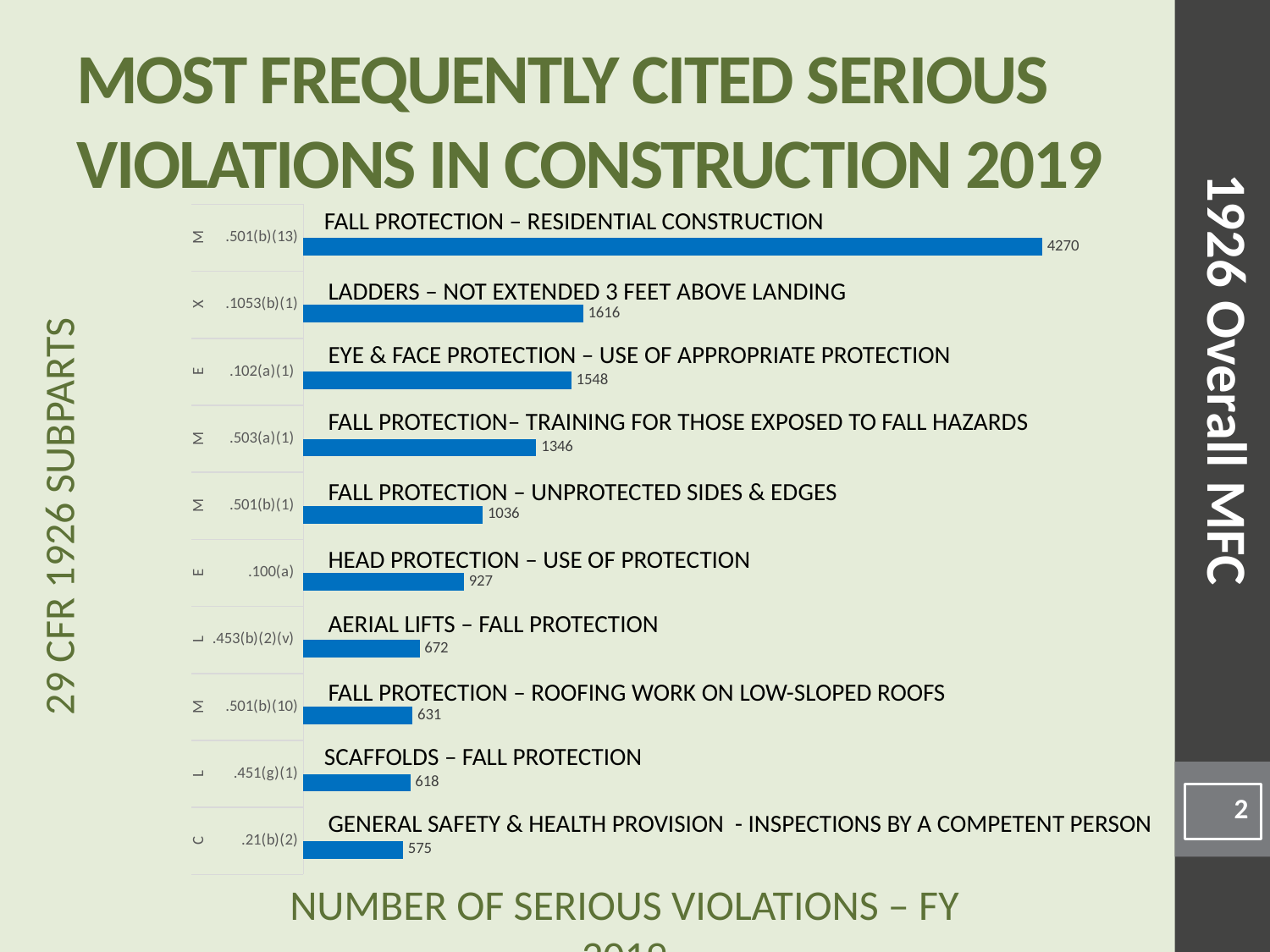
How many serious violations are shown for Fall Protection – Residential Construction (.501(b)(13))? 4270 What kind of chart is shown on the slide? Bar chart Which has a larger value: Fall Protection – Training for Those Exposed to Fall Hazards or Fall Protection – Unprotected Sides & Edges? Fall Protection – Training for Those Exposed to Fall Hazards Which has a larger value: Aerial Lifts – Fall Protection or Fall Protection – Roofing Work on Low-Sloped Roofs? Aerial Lifts – Fall Protection How many categories are shown in the chart? 10 What is the value for Head Protection – Use of Protection (.100(a))? 927 Which category has the lowest number of serious violations? General Safety & Health Provision - Inspections by a Competent Person What is the value for Scaffolds – Fall Protection (.451(g)(1))? 618 Which category has the highest number of serious violations? Fall Protection – Residential Construction What is the difference between the values for Fall Protection – Residential Construction and Ladders – Not Extended 3 Feet Above Landing? 2654 What is the difference between the values for Eye & Face Protection (.102(a)(1)) and Head Protection (.100(a))? 621 What is the value for Ladders – Not Extended 3 Feet Above Landing (.1053(b)(1))? 1616